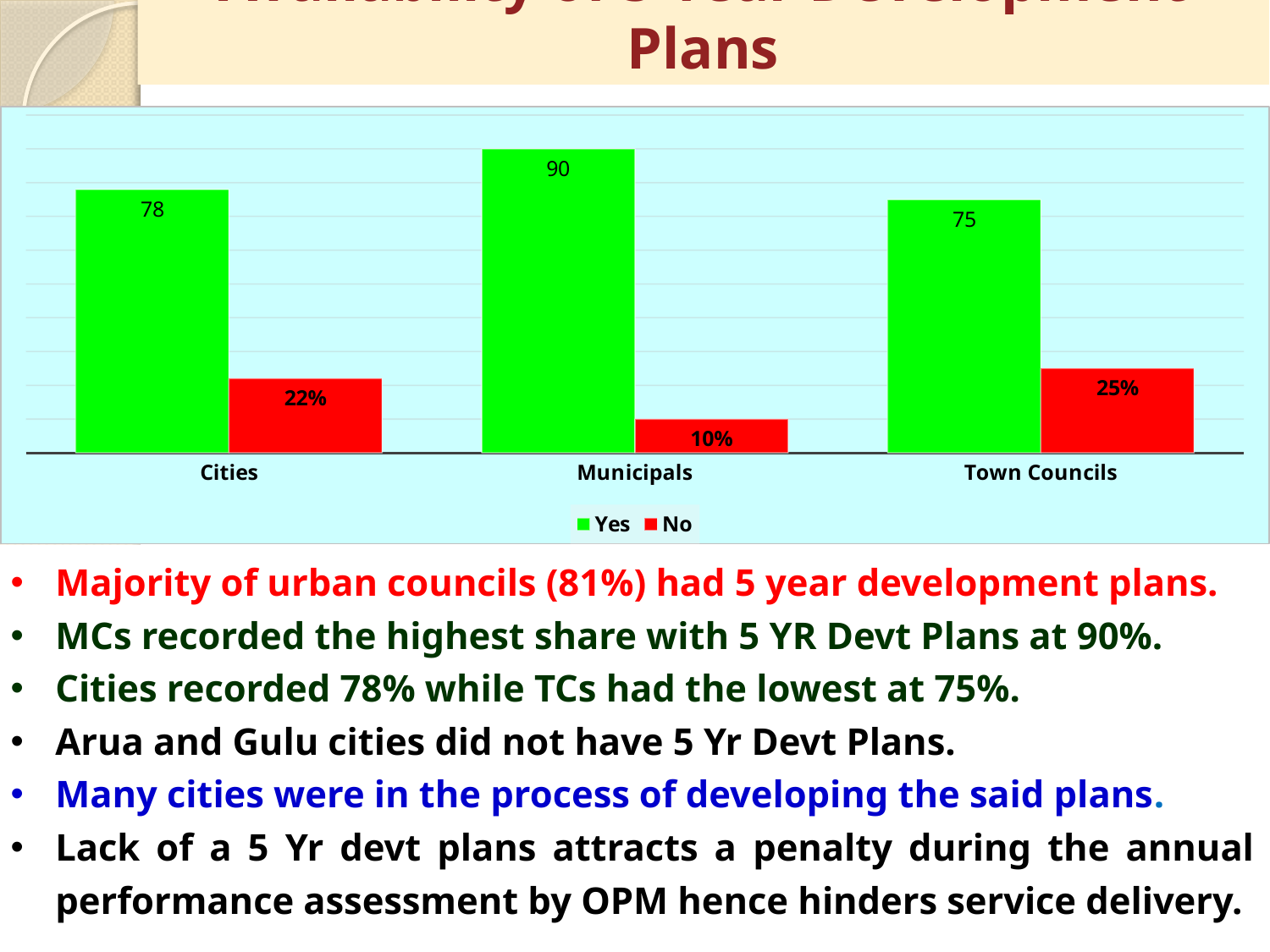
What is the value of the No bar for Town Councils? 25% What is the value of the Yes bar for Municipals? 90 Which category has the highest Yes value? Municipals What is the difference between the Yes values for Municipals and Cities? 12 How many series does the legend list? 2 Which colour represents the No series in the chart? Red Which is larger, the No value for Town Councils or the No value for Cities? Town Councils What kind of chart is shown on the slide? Bar chart What is the value of the Yes bar for Town Councils? 75 What is the value of the No bar for Cities? 22% Which category has the lowest No value? Municipals How many categories are shown on the x axis? 3